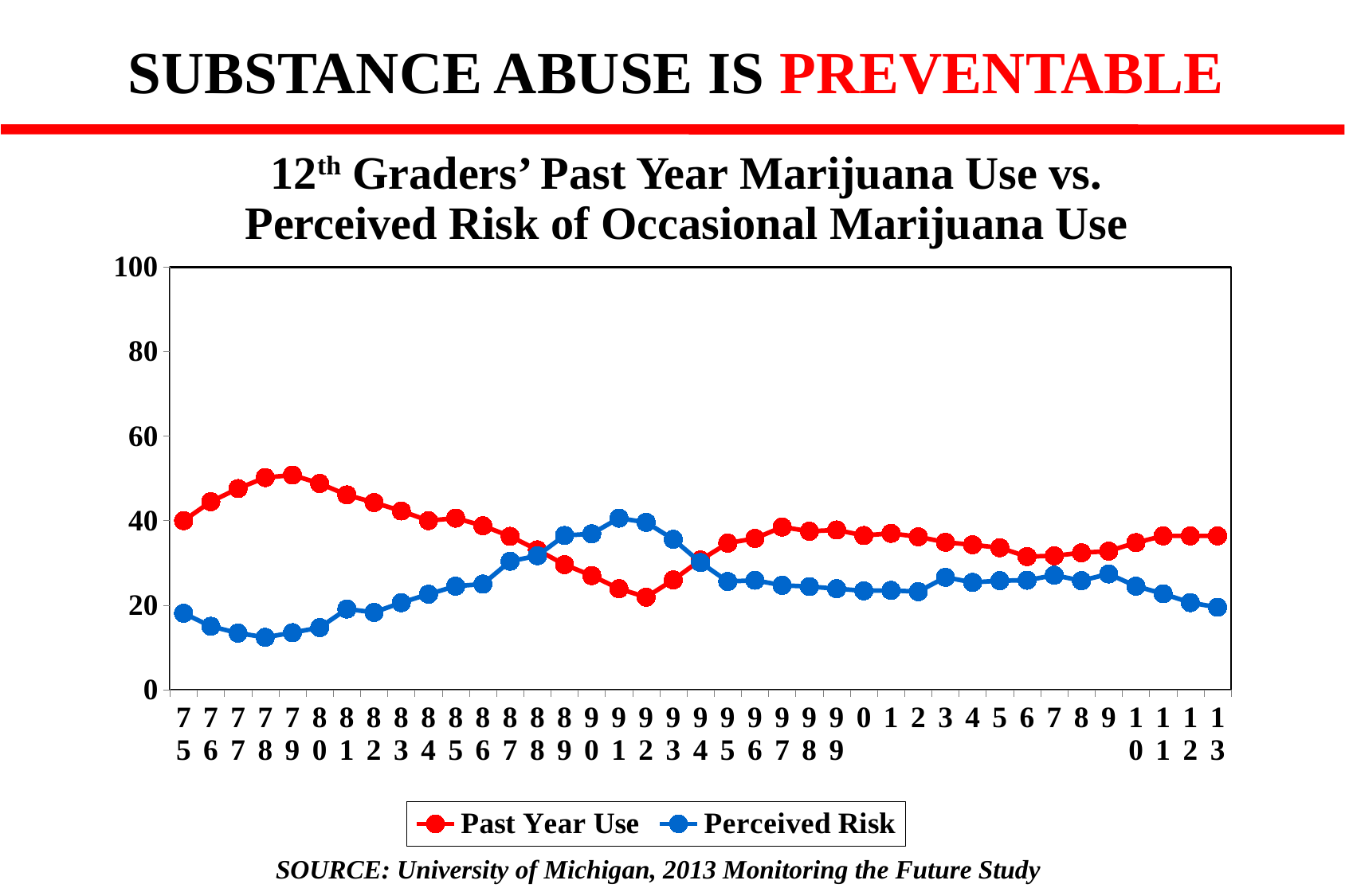
Is the value for Perceived Risk in 78 greater or less than 20? less How many series does the legend list? 2 In 91, which series has the higher value, Past Year Use or Perceived Risk? Perceived Risk Which series is drawn in red? Past Year Use In which year does Perceived Risk reach its highest value? 91 Is the value for Perceived Risk in 05 greater or less than 20? greater Is the value for Past Year Use in 79 greater or less than 40? greater In 13, which series has the higher value, Past Year Use or Perceived Risk? Past Year Use What is the title of the chart? 12th Graders' Past Year Marijuana Use vs. Perceived Risk of Occasional Marijuana Use What kind of chart is shown on the slide? Line chart Does Past Year Use rise or fall from 79 to 92? fall